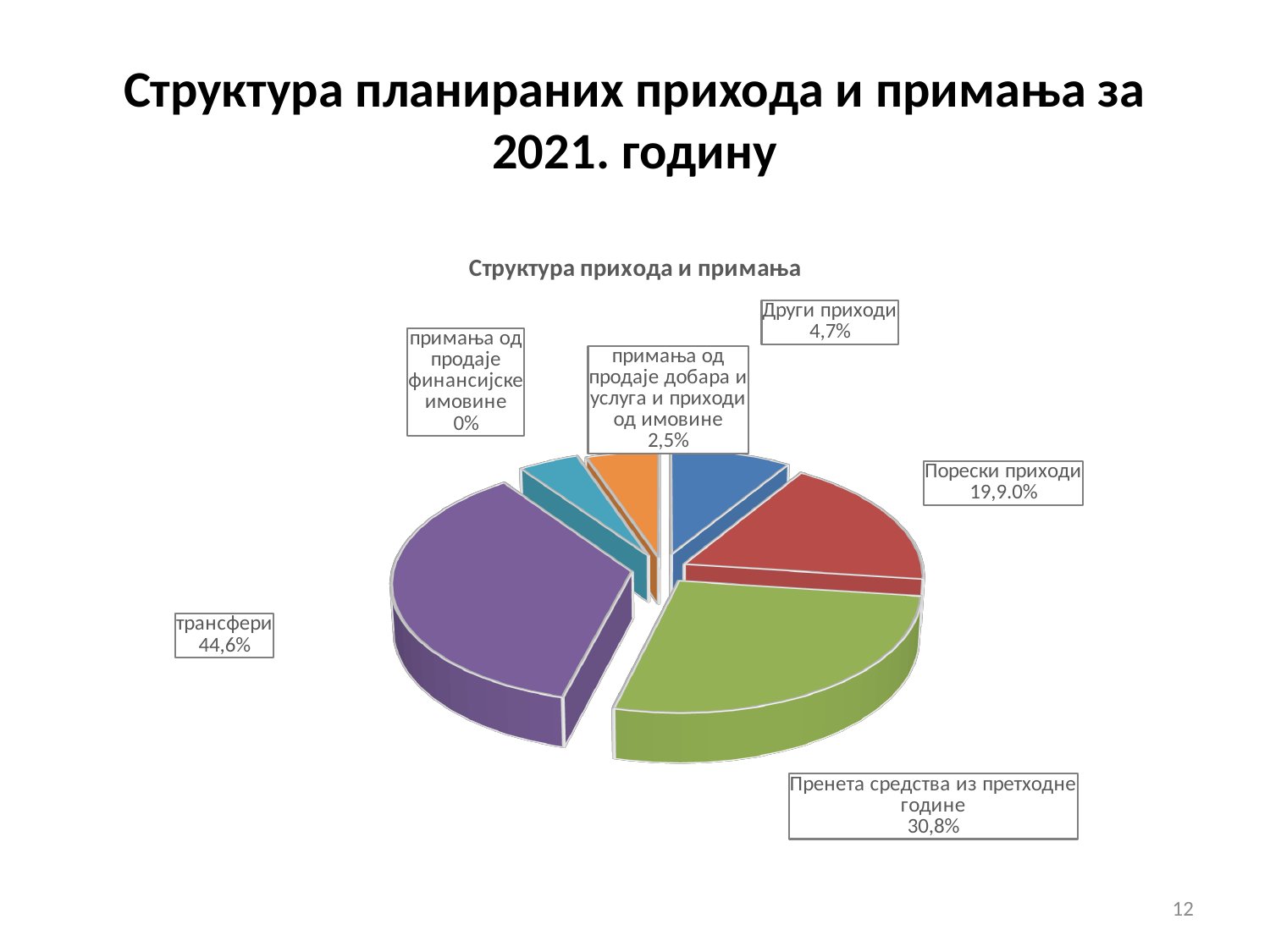
What is the difference in percentage points between трансфери and Пренета средства из претходне године? 13,8 What value is labelled for Порески приходи? 19,9.0% Which is larger, the share for Други приходи or the share for примања од продаје добара и услуга и приходи од имовине? Други приходи Which category has the largest share of the pie? трансфери What is the title of the chart? Структура прихода и примања What share of the pie does трансфери represent? 44,6% What percentage is shown for примања од продаје добара и услуга и приходи од имовине? 2,5% Which category has the smallest share of the pie? примања од продаје финансијске имовине What value is labelled for Други приходи? 4,7% What percentage is shown for Пренета средства из претходне године? 30,8% How many slices does the pie chart have? 6 What type of chart is shown on the slide? pie chart